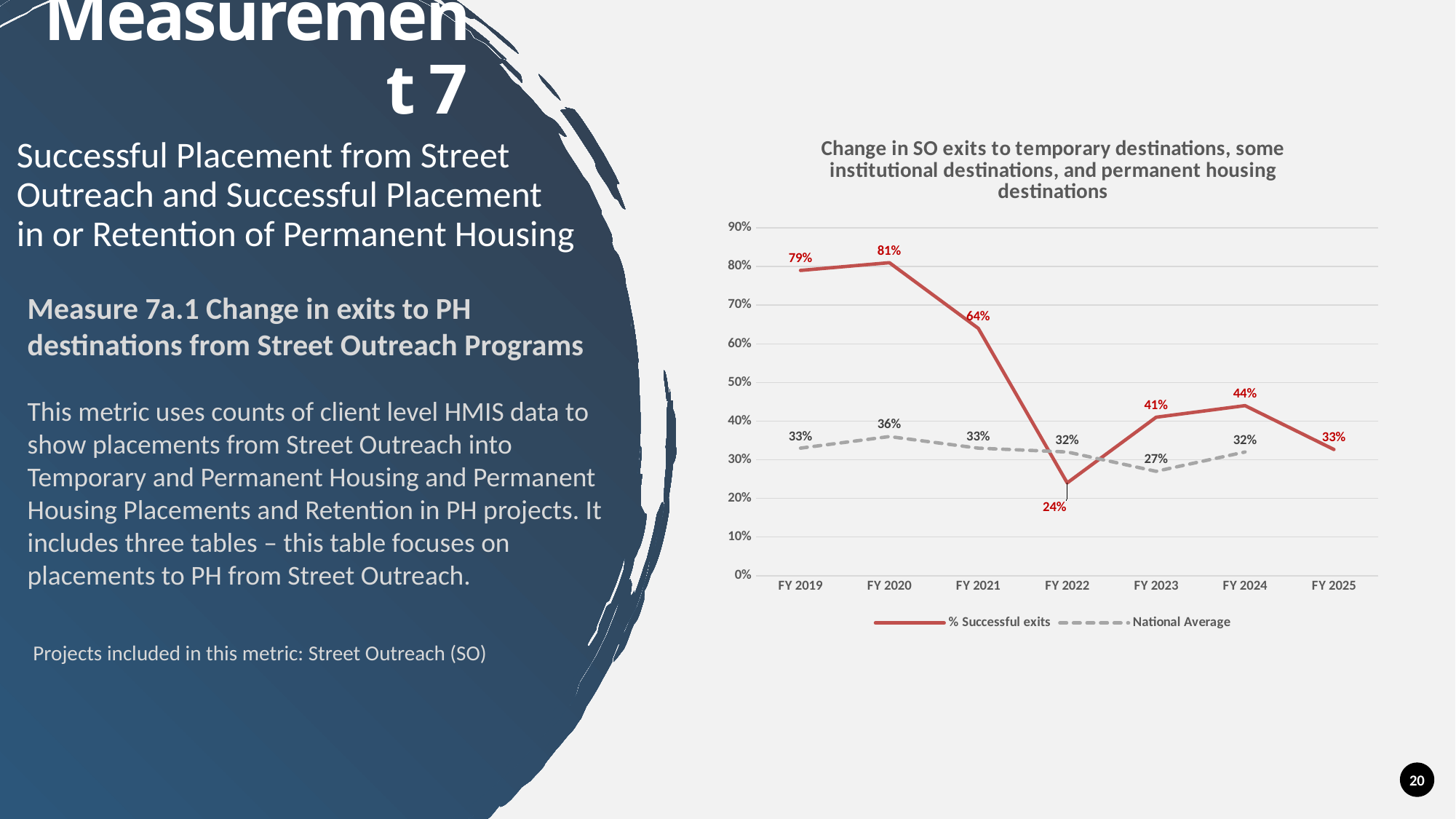
How many fiscal years are shown on the x axis? 7 Does the % Successful exits line rise or fall from FY 2020 to FY 2022? Fall What is the difference between the % Successful exits values for FY 2020 and FY 2021? 17% What is the % Successful exits value for FY 2020? 81% In which fiscal year is the % Successful exits value highest? FY 2020 What is the National Average value for FY 2023? 27% In which fiscal year is the % Successful exits value lowest? FY 2022 Which is larger in FY 2022: % Successful exits or National Average? National Average What is the % Successful exits value for FY 2025? 33% How many series does the legend list? 2 What type of chart is shown on the slide? Line chart What is the title of the chart? Change in SO exits to temporary destinations, some institutional destinations, and permanent housing destinations